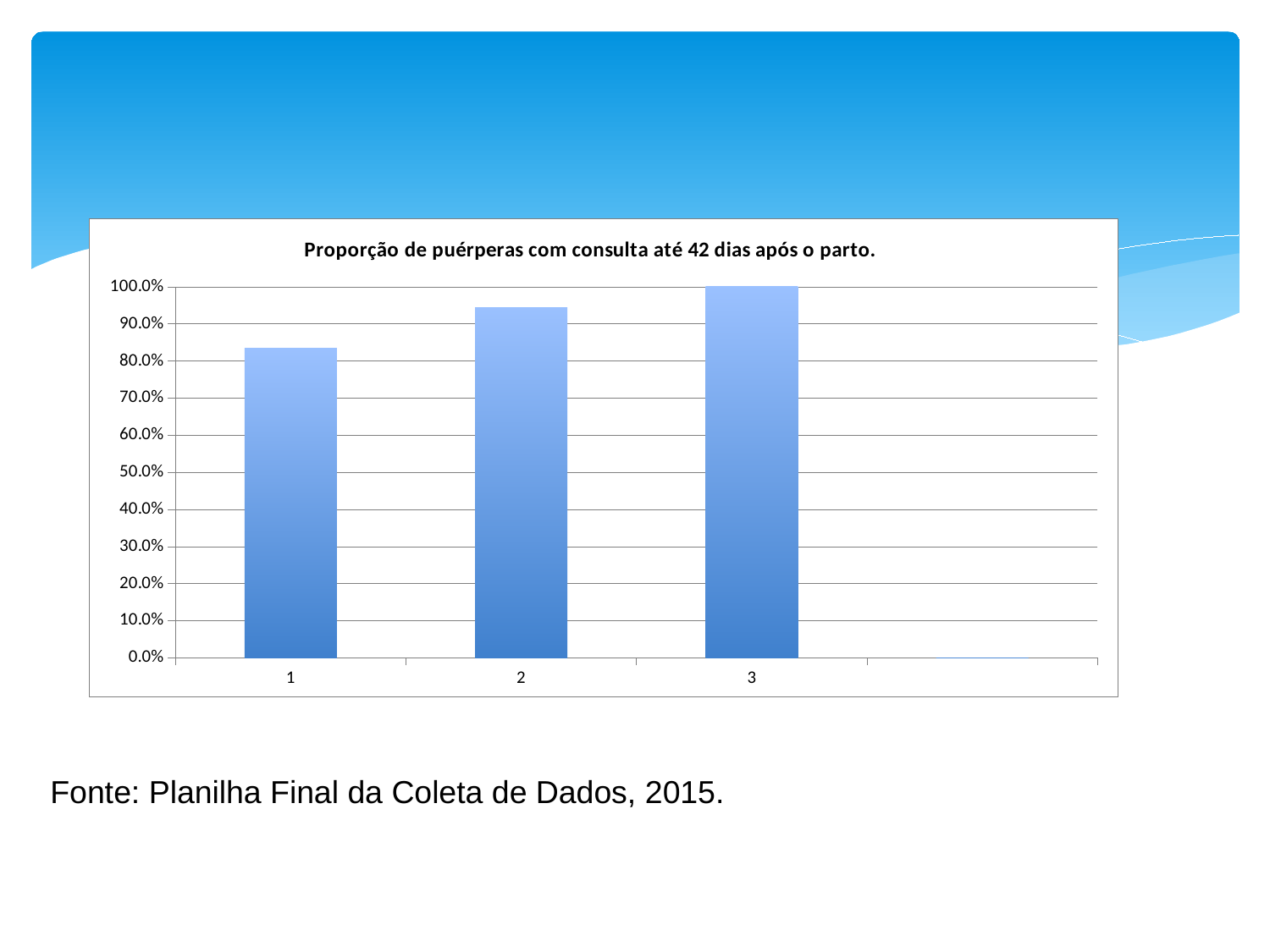
Which is larger, the value for category 1 or category 2? 2 Which category has the lowest bar? 1 Is the value for category 2 greater or less than 90.0%? greater How many bars are plotted in the chart? 3 Is the value for category 1 greater or less than 90.0%? less Which category has the highest bar? 3 What is the value for category 3? 100.0% Do the values rise or fall from category 1 to category 3? rise Which is larger, the value for category 2 or category 3? 3 What is the title of the chart? Proporção de puérperas com consulta até 42 dias após o parto. Is the value for category 1 greater or less than 80.0%? greater What kind of chart is shown on the slide? bar chart